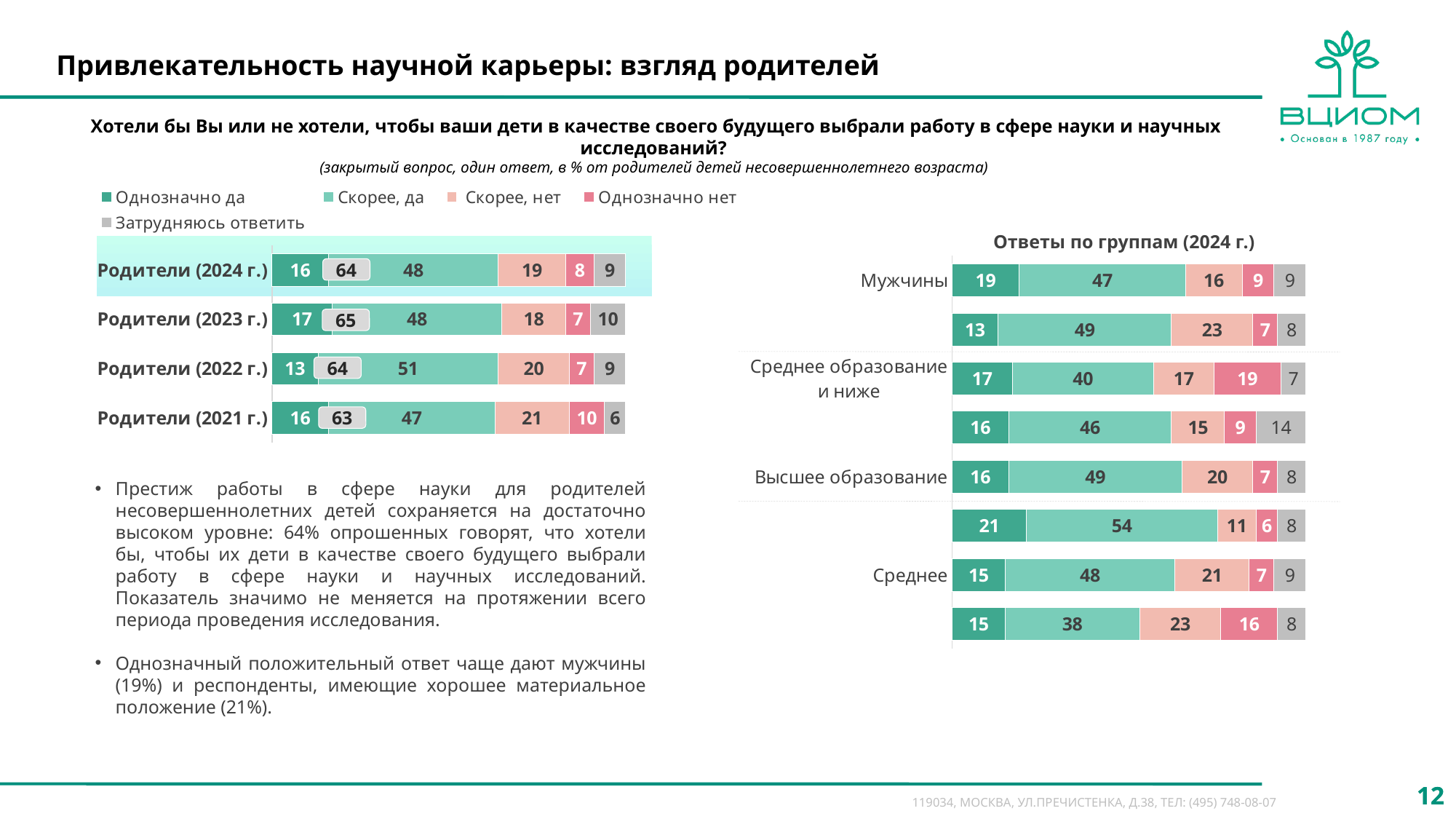
In the left chart, what is the total of the stacked bar for Родители (2023 г.)? 100 What kind of chart is the chart titled «Ответы по группам (2024 г.)»? Stacked bar chart In the left chart, what is the value of «Скорее, нет» for Родители (2021 г.)? 21 In the left chart, which year has the lowest value for «Однозначно да»? Родители (2022 г.) What is the title of the chart on the right side of the slide? Ответы по группам (2024 г.) In the chart «Ответы по группам (2024 г.)», what is the value of «Однозначно нет» for «Среднее образование и ниже»? 19 In the left chart, which year has the highest value for «Скорее, да»? Родители (2022 г.) In the left chart, what is the value of «Однозначно да» for Родители (2024 г.)? 16 In the chart «Ответы по группам (2024 г.)», which has the larger «Скорее, да» value: «Мужчины» or «Высшее образование»? Высшее образование How many series does the legend list? 5 In the left chart, what is the difference between the «Однозначно нет» values for Родители (2021 г.) and Родители (2024 г.)? 2 How many categories (years) are shown in the left chart? 4